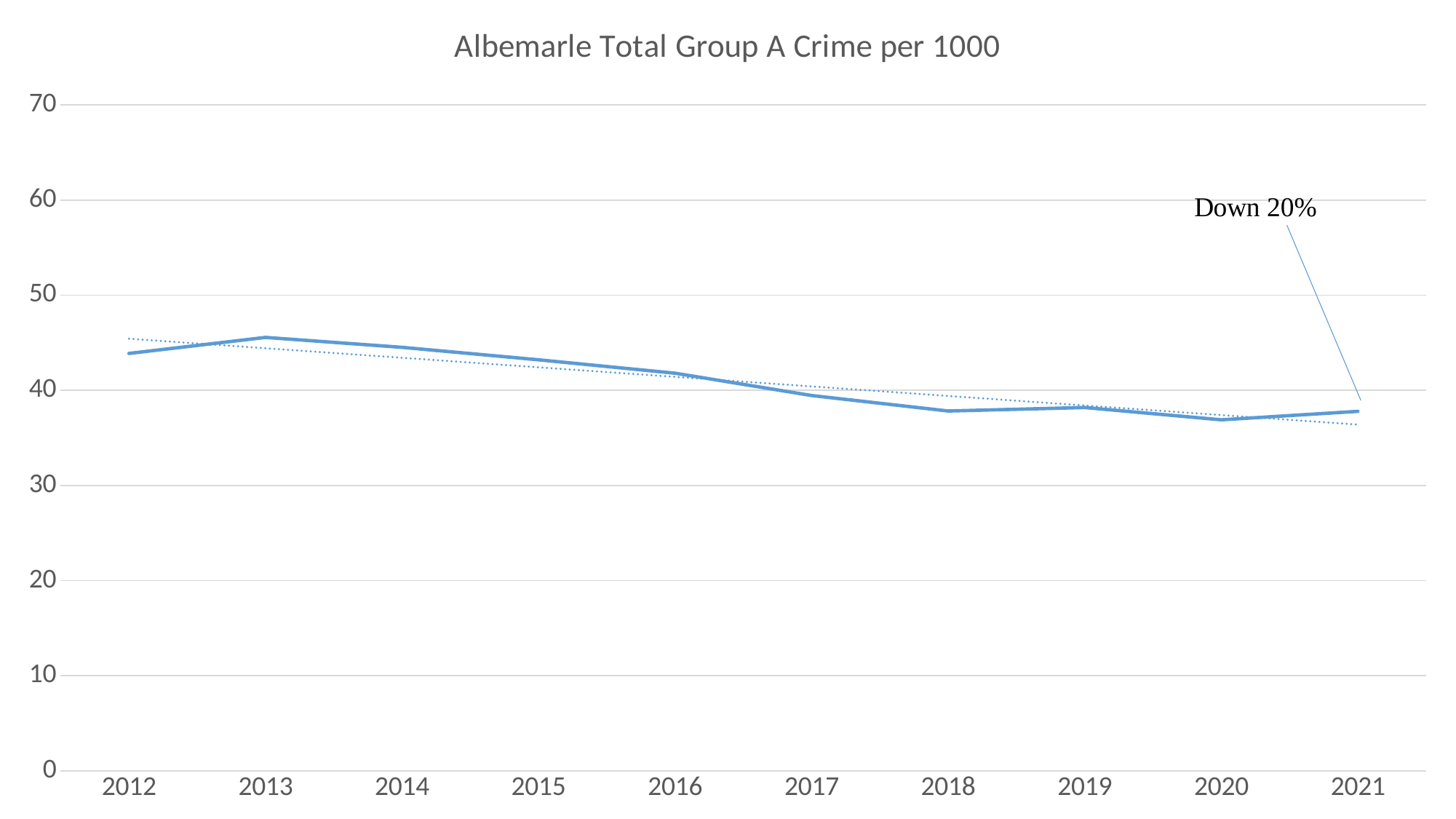
Which year has the higher value, 2013 or 2020? 2013 What is the title of the chart? Albemarle Total Group A Crime per 1000 Which year has the higher value, 2012 or 2018? 2012 What kind of chart is shown on the slide? line chart Do the values generally rise or fall from 2012 to 2021? fall What does the annotation pointing to the 2021 value say? Down 20% How many years are plotted along the x axis? 10 Is the value for 2020 greater or less than 30? greater Is the value for 2012 greater or less than 40? greater Is the value for 2021 greater or less than 40? less